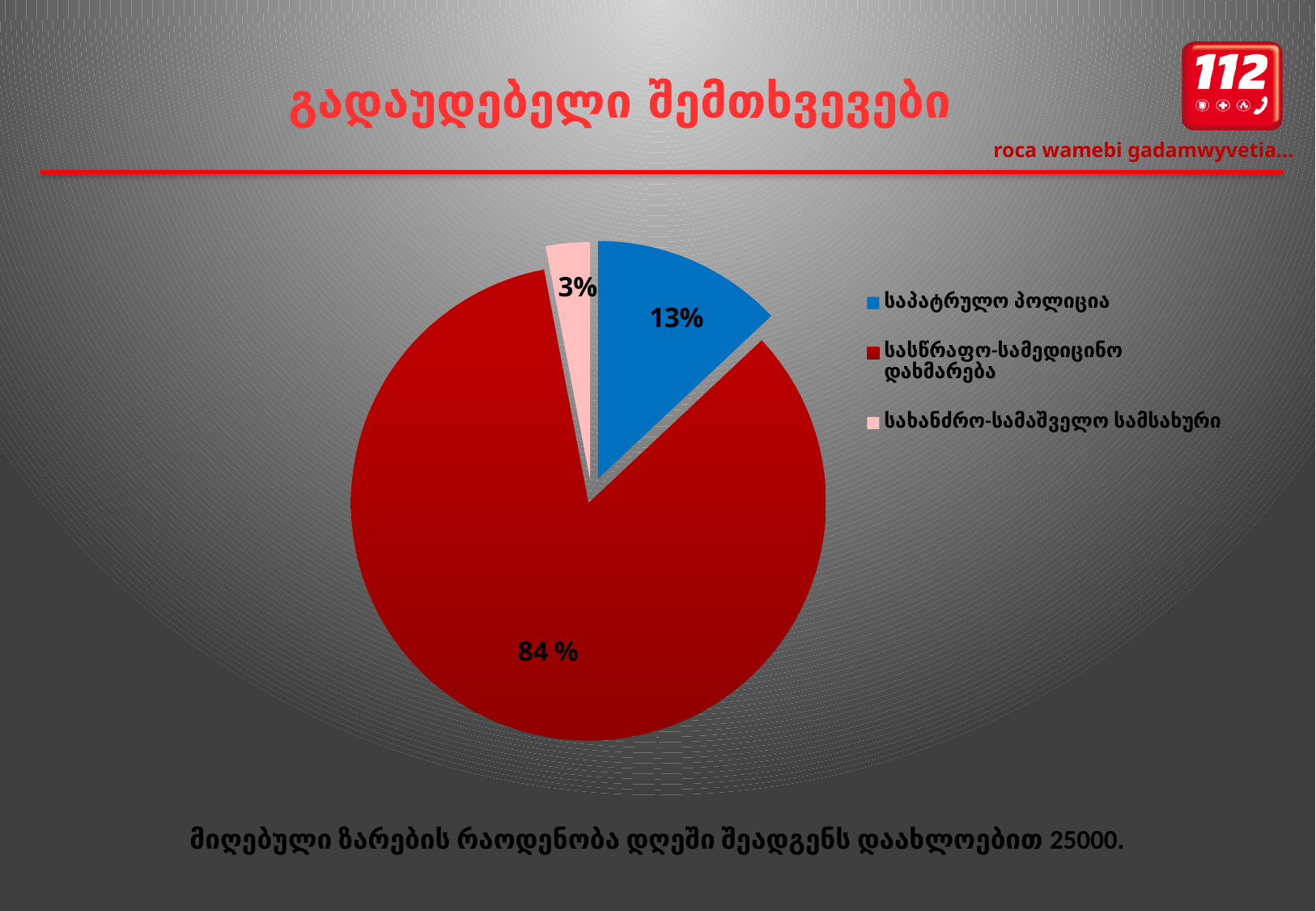
What share of the pie is labelled for სასწრაფო-სამედიცინო დახმარება? 84 % What kind of chart is shown on the slide? pie chart How many entries does the legend list? 3 Which category has the smallest slice of the pie? სახანძრო-სამაშველო სამსახური What colour is the slice for საპატრულო პოლიცია? blue How many slices does the pie chart have? 3 Which is larger, the slice for საპატრულო პოლიცია or the slice for სახანძრო-სამაშველო სამსახური? საპატრულო პოლიცია What is the title of the slide containing the pie chart? გადაუდებელი შემთხვევები What is the difference in percentage points between the slices for სასწრაფო-სამედიცინო დახმარება and საპატრულო პოლიცია? 71 What share of the pie is labelled for სახანძრო-სამაშველო სამსახური? 3% Which category has the largest slice of the pie? სასწრაფო-სამედიცინო დახმარება What share of the pie is labelled for საპატრულო პოლიცია? 13%